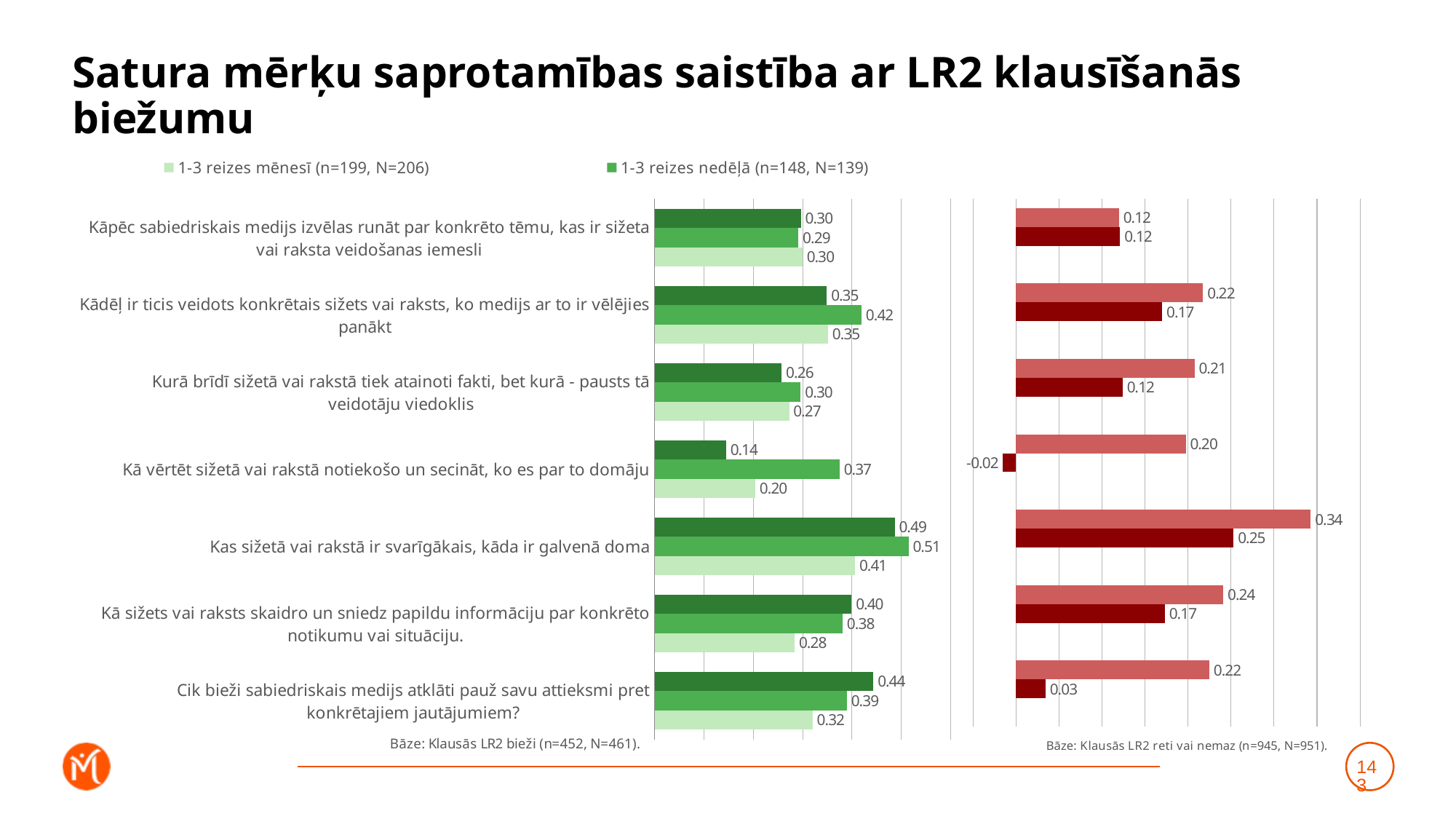
In the left-hand (green) chart, for 'Kādēļ ir ticis veidots konkrētais sižets vai raksts, ko medijs ar to ir vēlējies panākt', which is larger: '1-3 reizes mēnesī' or '1-3 reizes nedēļā'? 1-3 reizes nedēļā In the right-hand (red) chart, what is the highest value shown? 0.34 In the right-hand (red) chart, what is the lowest value shown? -0.02 What kind of chart is used on this slide? Bar chart In the left-hand (green) chart, what is the value for '1-3 reizes mēnesī' for 'Kā vērtēt sižetā vai rakstā notiekošo un secināt, ko es par to domāju'? 0.20 In the left-hand (green) chart, what is the difference between the '1-3 reizes nedēļā' and '1-3 reizes mēnesī' values for 'Kā vērtēt sižetā vai rakstā notiekošo un secināt, ko es par to domāju'? 0.17 How many categories (statements) are listed on the left-hand chart? 7 In the left-hand (green) chart, what is the value for '1-3 reizes nedēļā' for 'Kas sižetā vai rakstā ir svarīgākais, kāda ir galvenā doma'? 0.51 In the right-hand (red) chart, what is the difference between the top (lighter red) bar and the bottom (dark red) bar for 'Cik bieži sabiedriskais medijs atklāti pauž savu attieksmi pret konkrētajiem jautājumiem?'? 0.19 In the left-hand (green) chart, which category has the highest value for '1-3 reizes nedēļā'? Kas sižetā vai rakstā ir svarīgākais, kāda ir galvenā doma In the left-hand (green) chart, which category has the lowest value for '1-3 reizes mēnesī'? Kā vērtēt sižetā vai rakstā notiekošo un secināt, ko es par to domāju How many series does the legend at the top of the slide list? 2